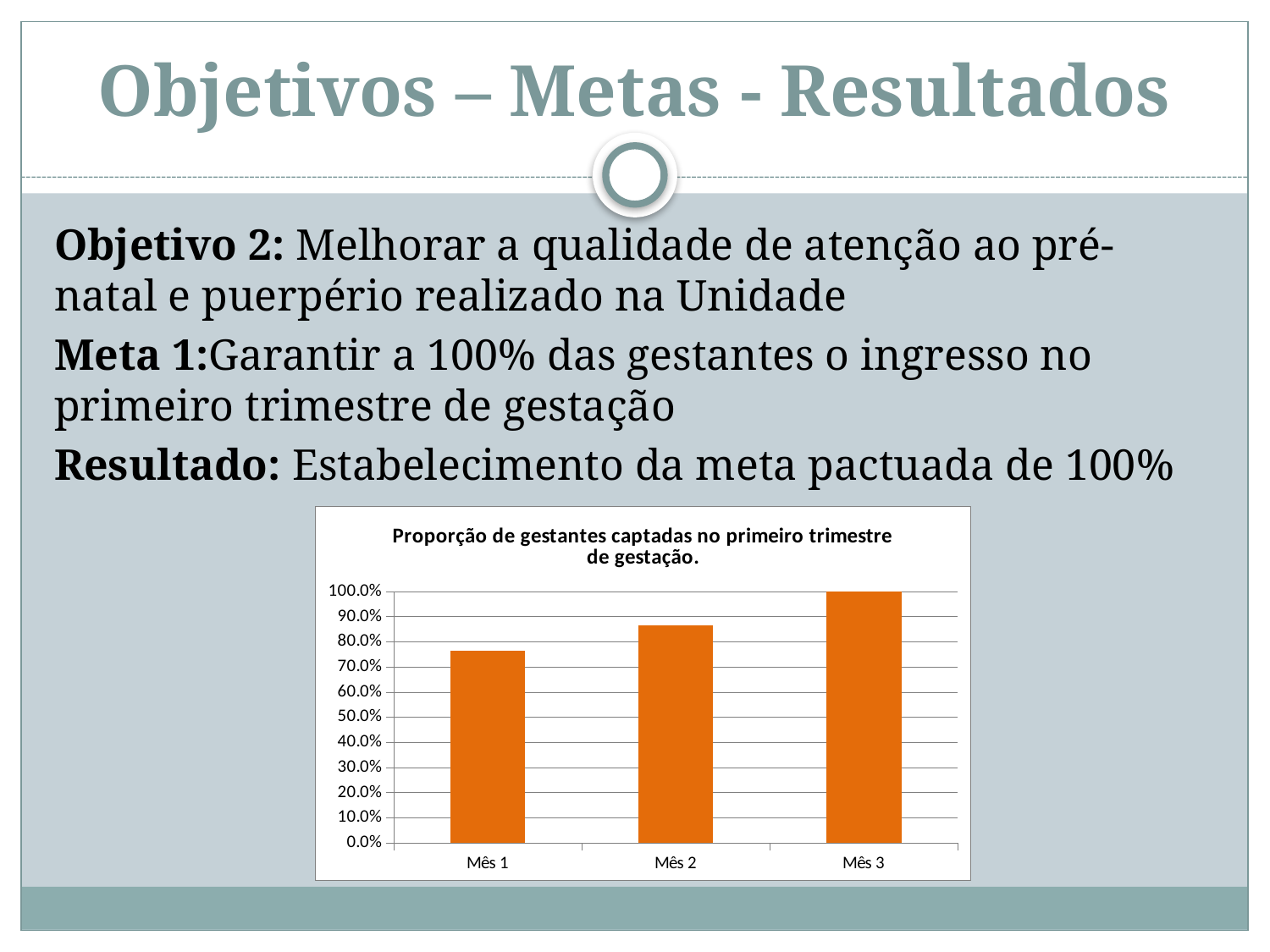
Is the value for Mês 2 greater or less than 80.0%? greater Is the value for Mês 1 greater or less than 80.0%? less What is the title of the chart? Proporção de gestantes captadas no primeiro trimestre de gestação. Which month has the highest proportion of pregnant women captured in the first trimester? Mês 3 Which month has the lowest proportion in the chart? Mês 1 Which is larger, the value for Mês 1 or the value for Mês 2? Mês 2 Is the value for Mês 1 greater or less than 70.0%? greater What kind of chart is shown on the slide? bar chart What is the value for Mês 3? 100.0% How many categories (months) are plotted in the chart? 3 Do the values rise or fall from Mês 1 to Mês 3? rise